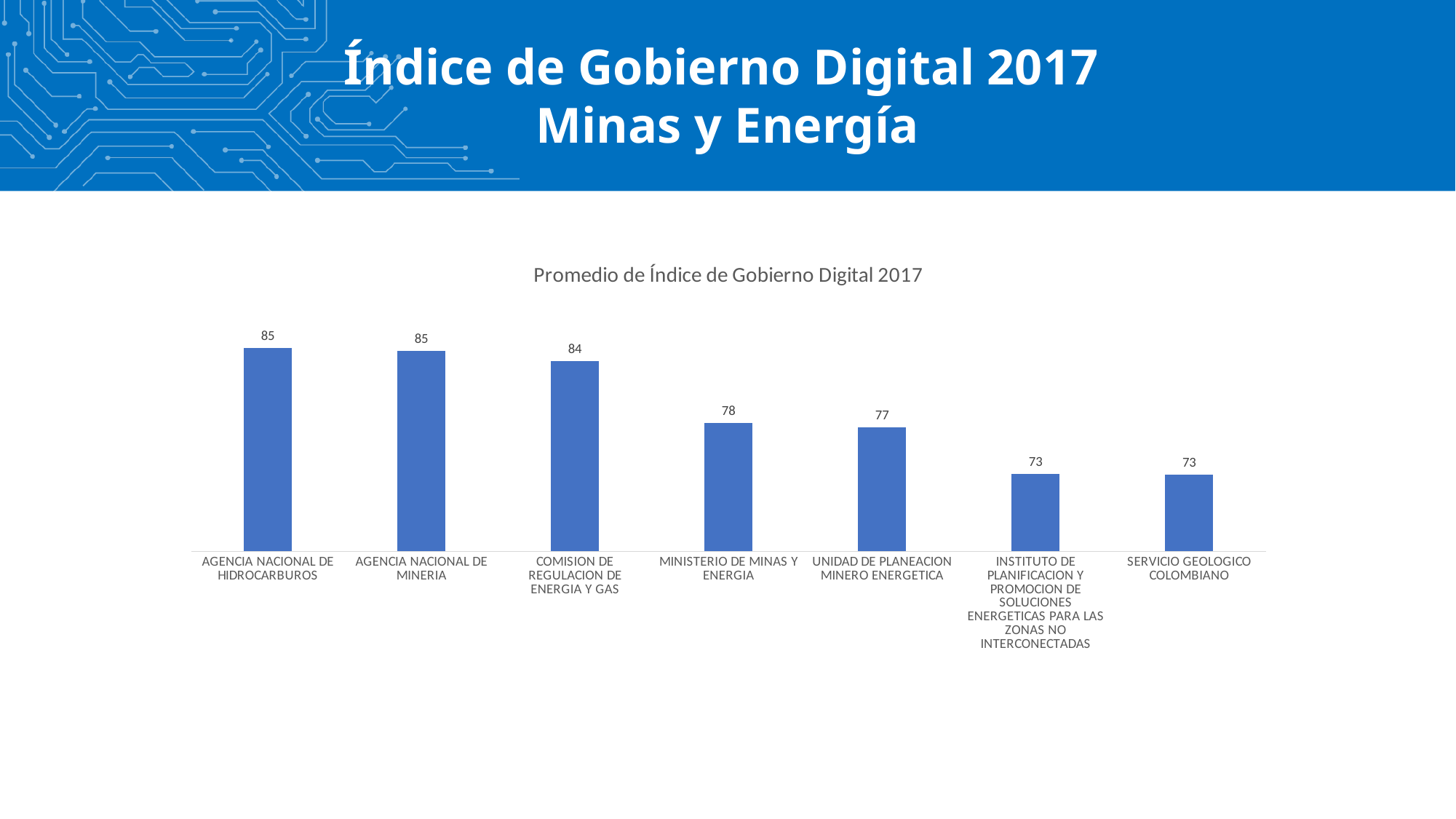
What is the difference between the values for AGENCIA NACIONAL DE MINERIA and SERVICIO GEOLOGICO COLOMBIANO? 12 What is the value for MINISTERIO DE MINAS Y ENERGIA? 78 How many categories are shown in the chart? 7 What is the value for UNIDAD DE PLANEACION MINERO ENERGETICA? 77 Do the values rise or fall from left to right across the chart? Fall What is the value for AGENCIA NACIONAL DE HIDROCARBUROS? 85 What is the title of the chart? Promedio de Índice de Gobierno Digital 2017 What is the difference between the values for COMISION DE REGULACION DE ENERGIA Y GAS and MINISTERIO DE MINAS Y ENERGIA? 6 What is the value for SERVICIO GEOLOGICO COLOMBIANO? 73 Which has a larger value, MINISTERIO DE MINAS Y ENERGIA or SERVICIO GEOLOGICO COLOMBIANO? MINISTERIO DE MINAS Y ENERGIA What kind of chart is shown on the slide? Bar chart What is the value for COMISION DE REGULACION DE ENERGIA Y GAS? 84